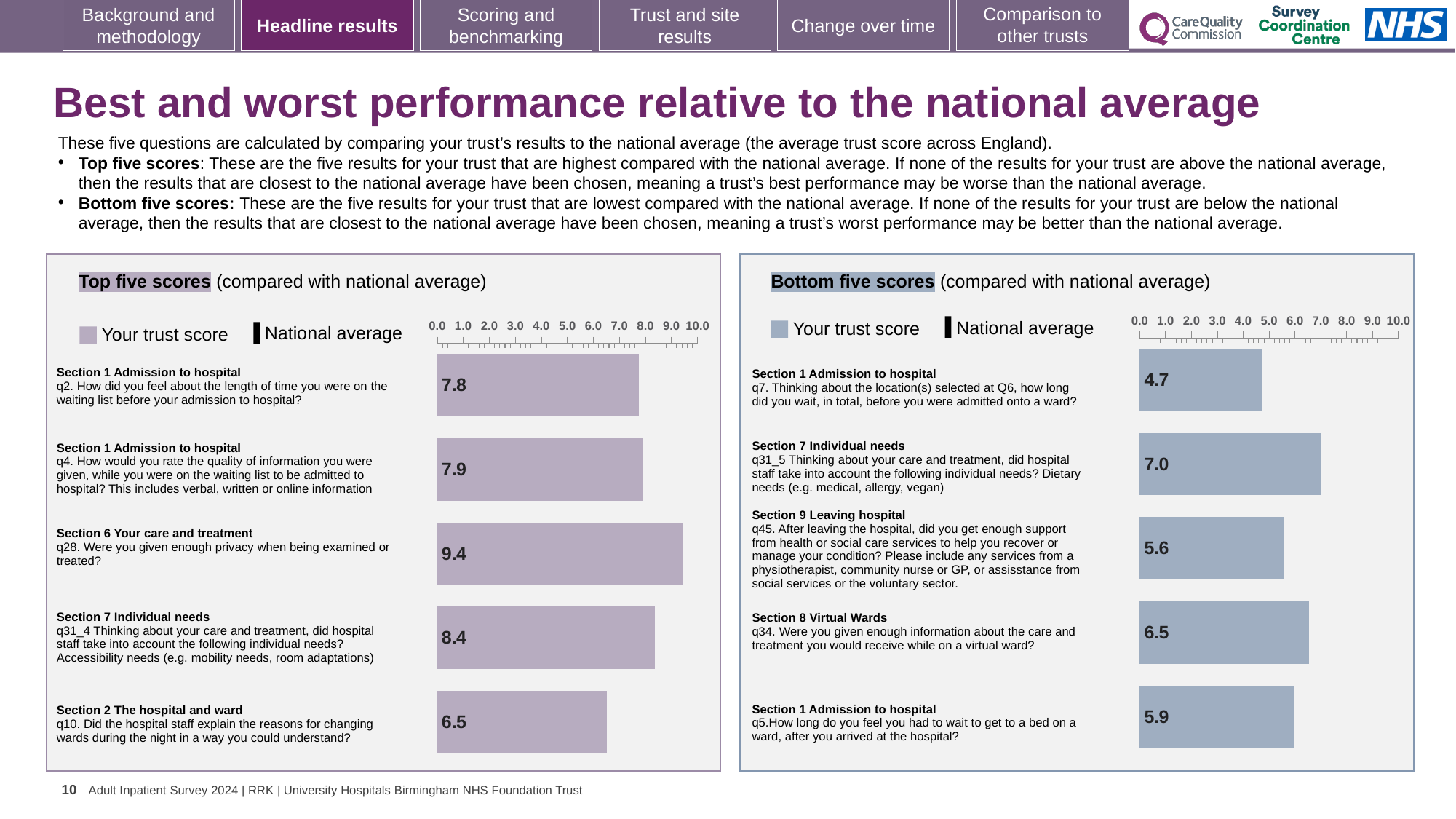
In the Top five scores chart, what is the trust score for q28 (Were you given enough privacy when being examined or treated?)? 9.4 In the Top five scores chart, which question has the highest trust score? q28 In the Top five scores chart, what is the difference between the trust scores for q28 and q10? 2.9 In the Bottom five scores chart, which question has the lowest trust score? q7 What type of chart is the Top five scores chart? Bar chart In the Top five scores chart, what is the trust score for q10 (Did the hospital staff explain the reasons for changing wards during the night)? 6.5 In the Bottom five scores chart, what is the difference between the trust scores for q31_5 and q7? 2.3 In the Bottom five scores chart, what is the trust score for q7 (how long did you wait before you were admitted onto a ward)? 4.7 How many bars are plotted in the Bottom five scores chart? 5 In the Bottom five scores chart, what is the trust score for q34 (information about care and treatment on a virtual ward)? 6.5 In the Bottom five scores chart, which question has the highest trust score? q31_5 In the Top five scores chart, which has the larger trust score: q2 or q31_4? q31_4